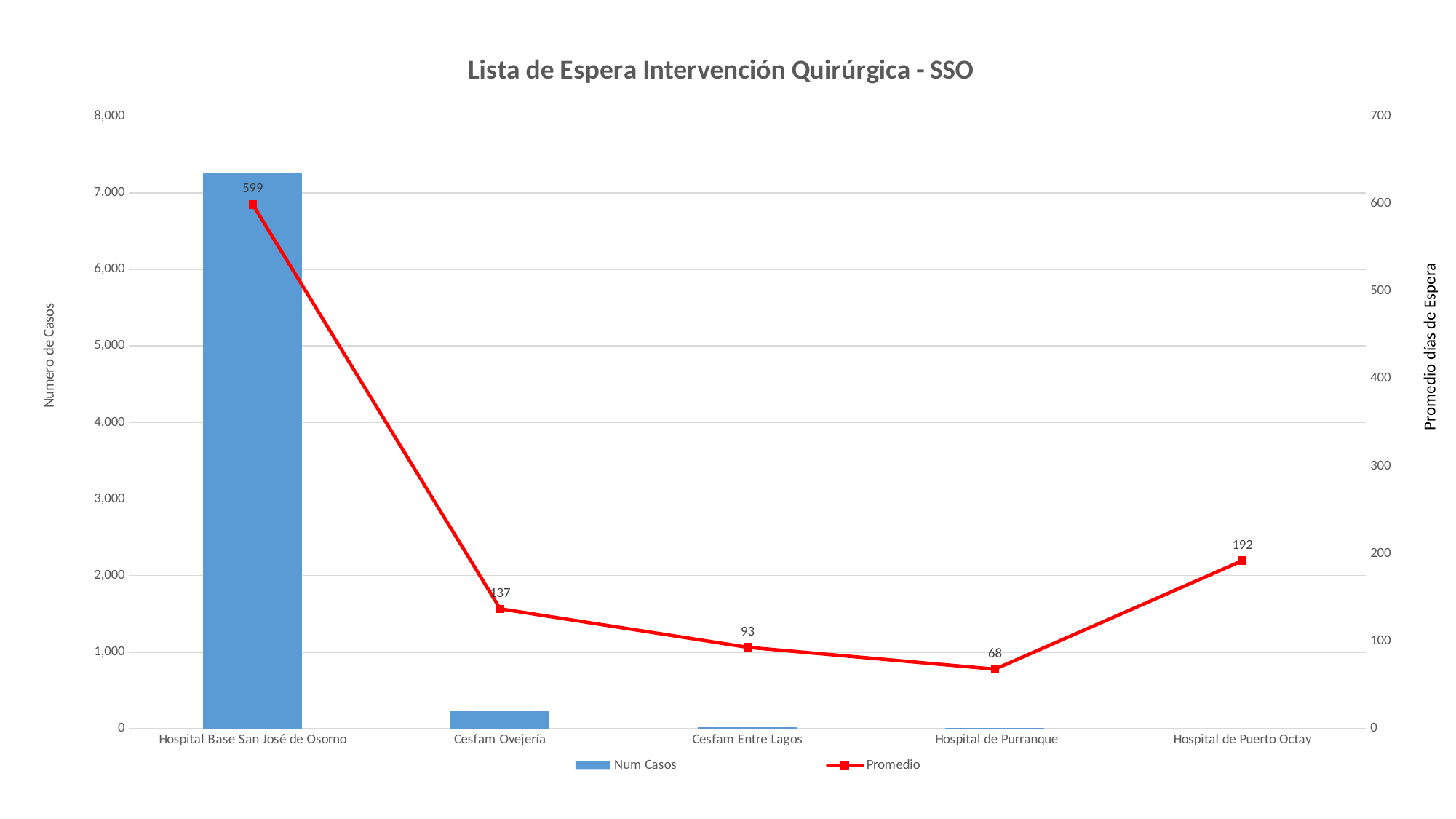
Which category has the highest Promedio value? Hospital Base San José de Osorno What is the Promedio value for Hospital de Puerto Octay? 192 What is the Promedio value for Hospital de Purranque? 68 What is the Promedio value for Hospital Base San José de Osorno? 599 How many categories are shown on the x axis? 5 Is the Num Casos value for Hospital Base San José de Osorno greater or less than 7,000? greater Which has a larger Promedio value, Cesfam Ovejería or Cesfam Entre Lagos? Cesfam Ovejería How many series does the legend list? 2 What is the title of the right-hand vertical axis? Promedio días de Espera Which category has the lowest Promedio value? Hospital de Purranque Is the Num Casos value for Cesfam Ovejería greater or less than 1,000? less What is the difference between the Promedio values for Hospital Base San José de Osorno and Cesfam Ovejería? 462